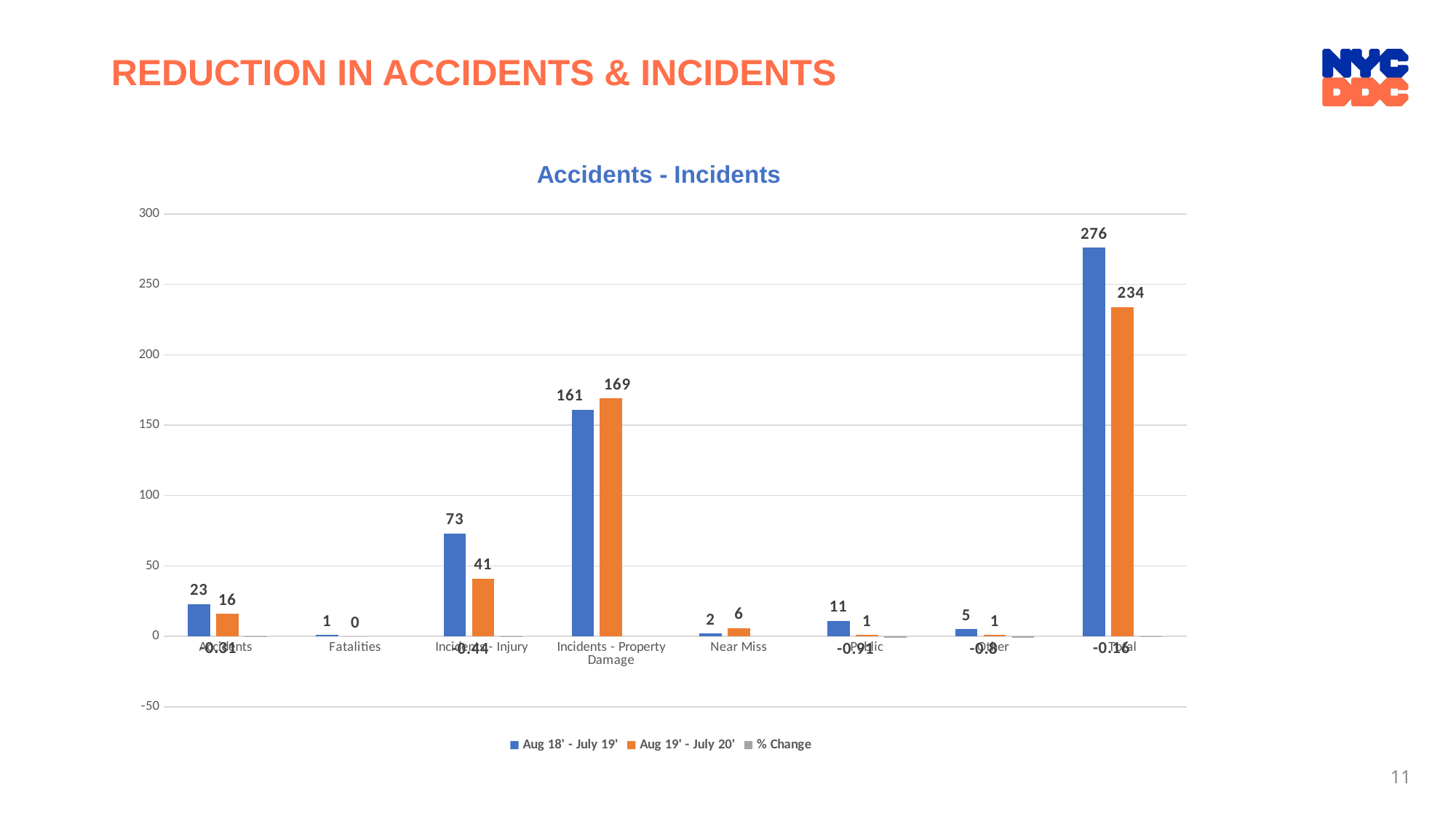
What is the difference between the Aug 18' - July 19' and Aug 19' - July 20' values for Incidents - Injury? 32 What is the value for Incidents - Injury in the Aug 18' - July 19' series? 73 Which category has the lowest value in the Aug 19' - July 20' series? Fatalities What is the value for Incidents - Property Damage in the Aug 19' - July 20' series? 169 Is the Aug 18' - July 19' value for Total greater or less than 250? greater What type of chart is shown on the slide? Bar chart How many categories are shown on the x axis? 8 How many series does the legend list? 3 For Near Miss, which series has the larger value: Aug 18' - July 19' or Aug 19' - July 20'? Aug 19' - July 20' What is the value for Public in the Aug 18' - July 19' series? 11 What is the Total value for the Aug 19' - July 20' series? 234 Excluding Total, which category has the highest value in the Aug 18' - July 19' series? Incidents - Property Damage